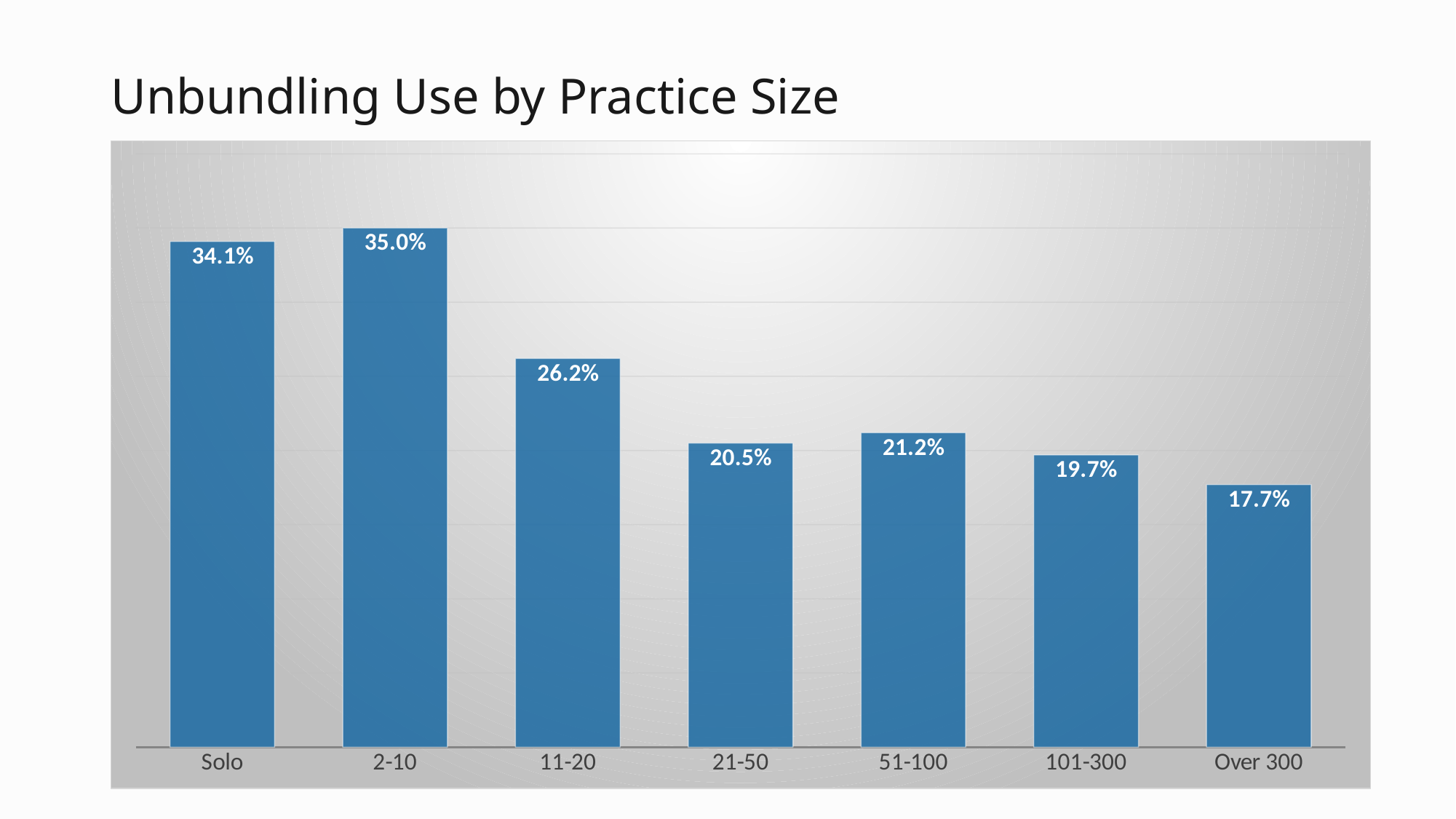
Which practice size has the lowest value? Over 300 What is the value for the Over 300 practice size? 17.7% What is the difference between the values for Solo and 11-20? 7.9% What is the title of the chart? Unbundling Use by Practice Size Which is larger, the value for 21-50 or the value for 101-300? 21-50 What is the value for the 51-100 practice size? 21.2% What is the value for the 2-10 practice size? 35.0% What is the value for the 11-20 practice size? 26.2% What is the difference between the values for 2-10 and Over 300? 17.3% How many practice size categories are shown on the chart? 7 Which practice size has the highest value? 2-10 What kind of chart is shown on the slide? Bar chart